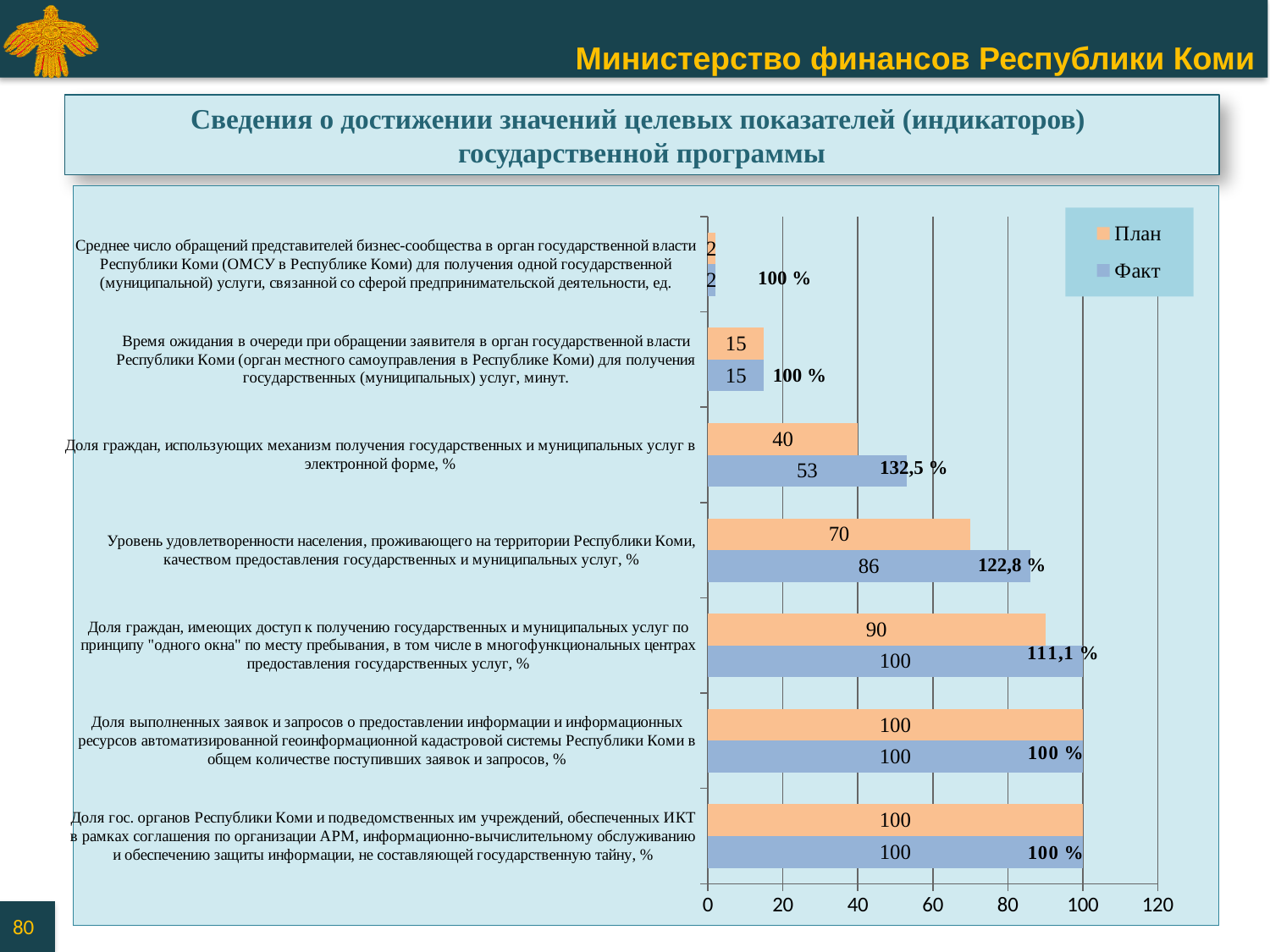
Which is larger for 'Доля граждан, использующих механизм получения ... услуг в электронной форме, %': the План value or the Факт value? Факт What are the two series named in the chart legend? План and Факт Which category has the lowest План value? Среднее число обращений представителей бизнес-сообщества ... ед. What is the Факт value for 'Доля граждан, использующих механизм получения государственных и муниципальных услуг в электронной форме, %'? 53 Is the Факт value for 'Доля граждан, имеющих доступ ... по принципу "одного окна"' greater or less than 80? greater How many series does the chart legend list? 2 What is the difference between the Факт and План values for 'Уровень удовлетворенности населения ... качеством предоставления государственных и муниципальных услуг, %'? 16 What is the План value for 'Время ожидания в очереди при обращении заявителя ... минут'? 15 What is the План value for 'Уровень удовлетворенности населения, проживающего на территории Республики Коми, качеством предоставления государственных и муниципальных услуг, %'? 70 What percentage label is shown next to the bars for 'Доля граждан, имеющих доступ к получению государственных и муниципальных услуг по принципу "одного окна"'? 111,1 % What type of chart is shown on the slide? Bar chart How many categories (indicators) are plotted on the chart? 7